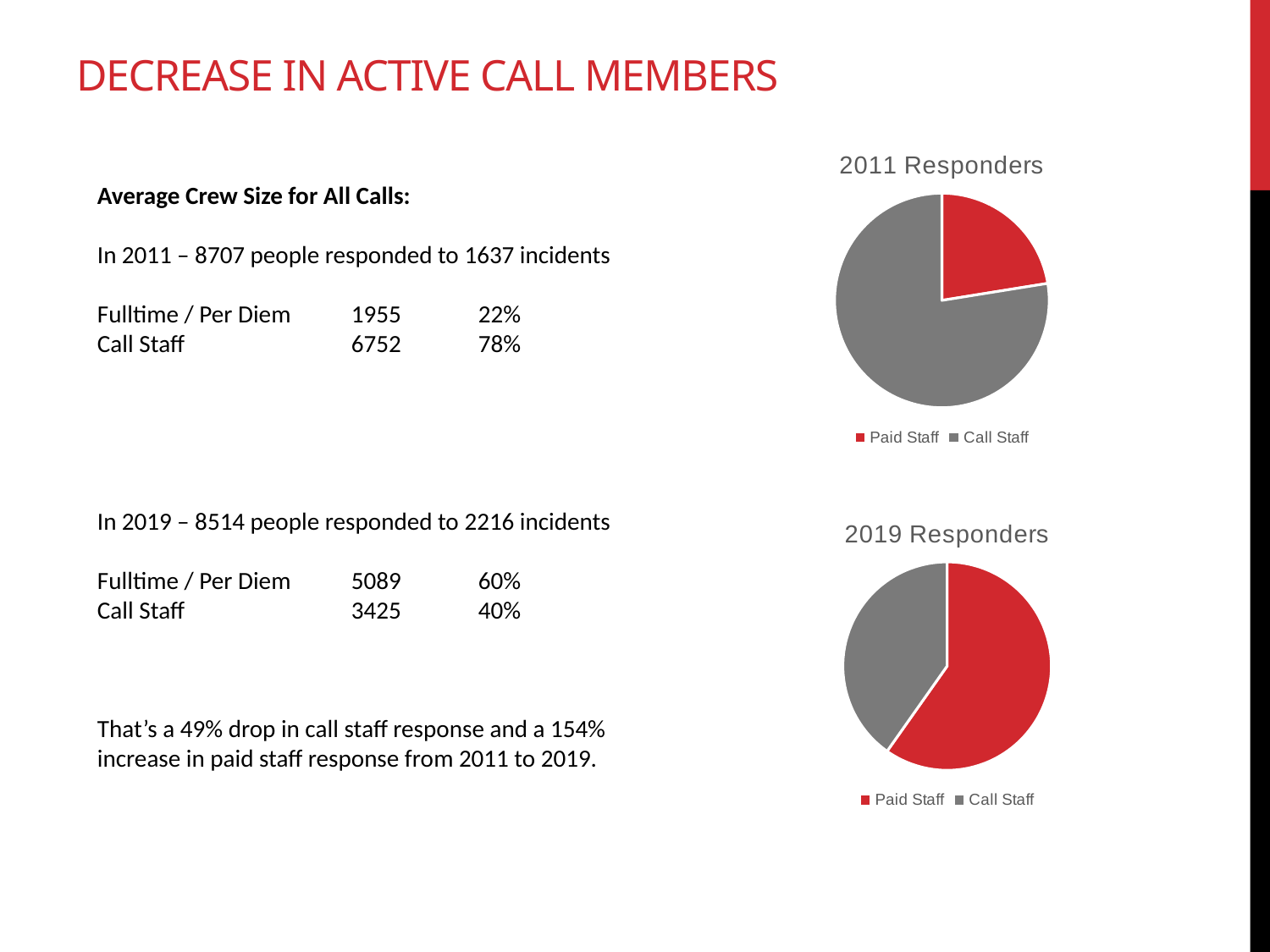
In the "2019 Responders" chart, what share of the pie is Paid Staff? 60% What kind of chart is the "2011 Responders" chart? Pie chart How many slices does the "2011 Responders" pie chart have? 2 What is the title of the pie chart at the top right of the slide? 2011 Responders In the "2019 Responders" chart, which slice is larger, Paid Staff or Call Staff? Paid Staff What kind of chart is the "2019 Responders" chart? Pie chart How many entries does the legend of the "2019 Responders" chart list? 2 In the "2011 Responders" chart, what share of the pie is Call Staff? 78% In the "2019 Responders" chart, which category has the largest slice? Paid Staff In the "2011 Responders" chart, which slice is larger, Paid Staff or Call Staff? Call Staff In the "2011 Responders" chart, which category has the smallest slice? Paid Staff What colour represents Paid Staff in the "2019 Responders" chart? Red